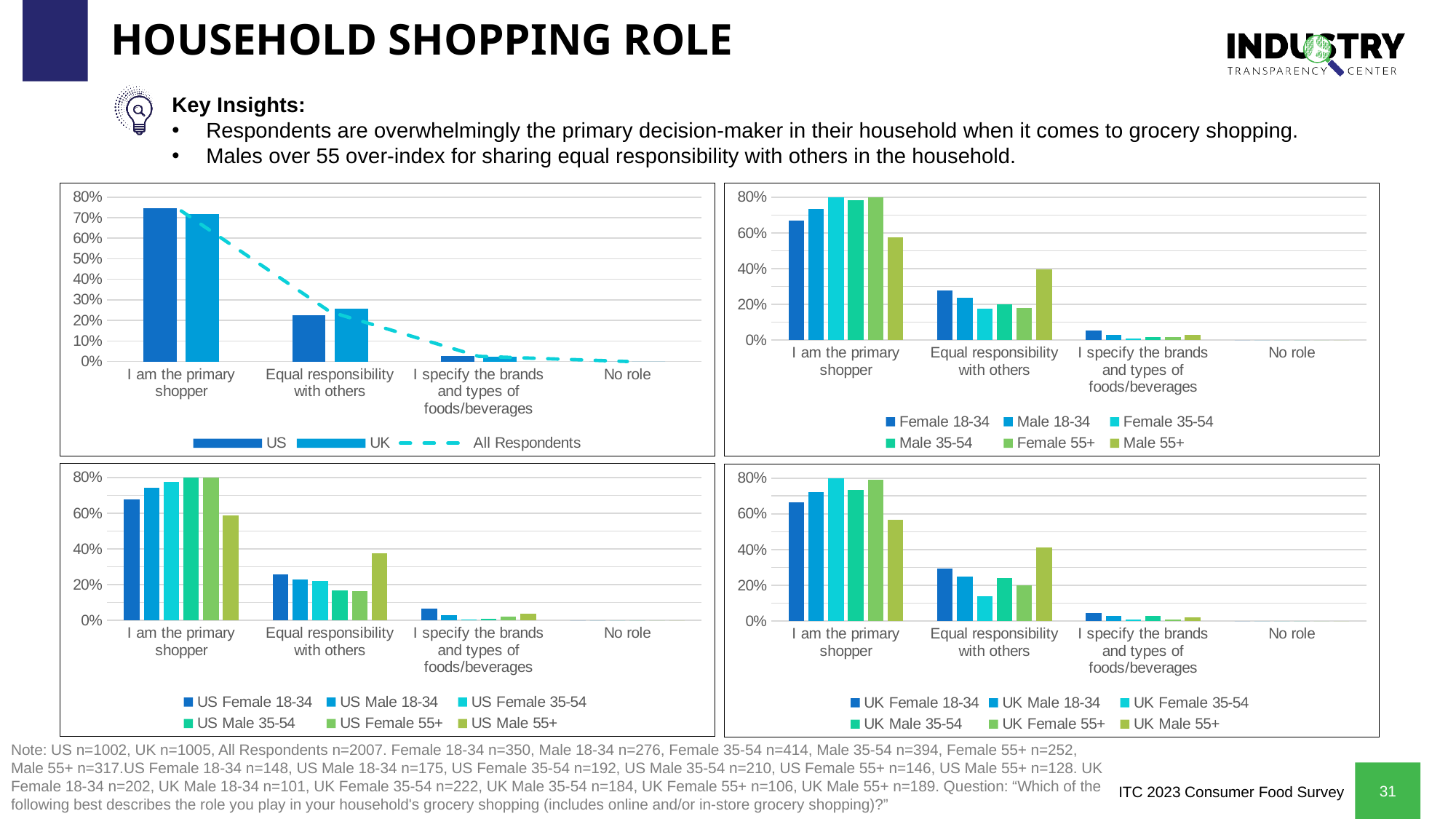
How many charts are on the slide? 4 In the top-right chart, which series has the highest value for 'Equal responsibility with others'? Male 55+ In the top-left chart, is the US value for 'I am the primary shopper' greater or less than 70%? greater In the top-left chart, which is larger for 'Equal responsibility with others': US or UK? UK In the top-right chart, how many series does the legend list? 6 In the top-left chart, do the values rise or fall moving from left to right along the x axis? fall In the top-left chart, how many series does the legend list? 3 What type of chart is the top-left chart? combination bar and line chart In the top-left chart, how many categories are shown on the x axis? 4 In the top-left chart, which category has the highest values for both US and UK? I am the primary shopper